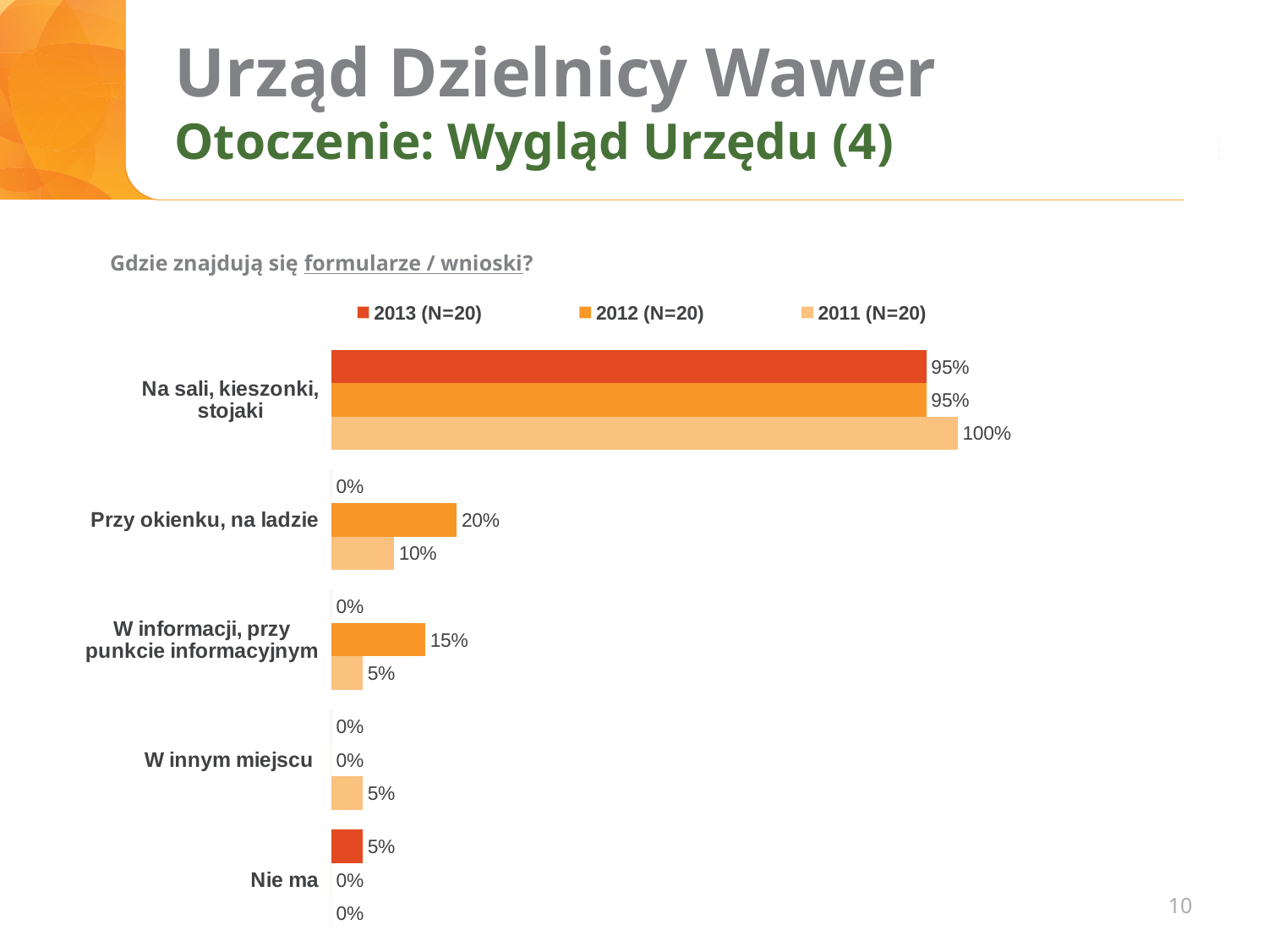
What is the value for "W informacji, przy punkcie informacyjnym" in the 2011 (N=20) series? 5% What is the difference between the 2012 (N=20) and 2011 (N=20) values for "Przy okienku, na ladzie"? 10% What question does the chart answer, as stated above it? Gdzie znajdują się formularze / wnioski? What is the value for "Nie ma" in the 2013 (N=20) series? 5% Which category has the highest value in the 2011 (N=20) series? Na sali, kieszonki, stojaki How many series does the legend list? 3 What is the value for "Przy okienku, na ladzie" in the 2012 (N=20) series? 20% What is the difference between the 2011 (N=20) and 2013 (N=20) values for "Na sali, kieszonki, stojaki"? 5% How many categories are shown on the chart? 5 What is the value for "Na sali, kieszonki, stojaki" in the 2013 (N=20) series? 95% What kind of chart is shown on the slide? Bar chart Which is larger for "W informacji, przy punkcie informacyjnym": the 2012 (N=20) value or the 2011 (N=20) value? 2012 (N=20)